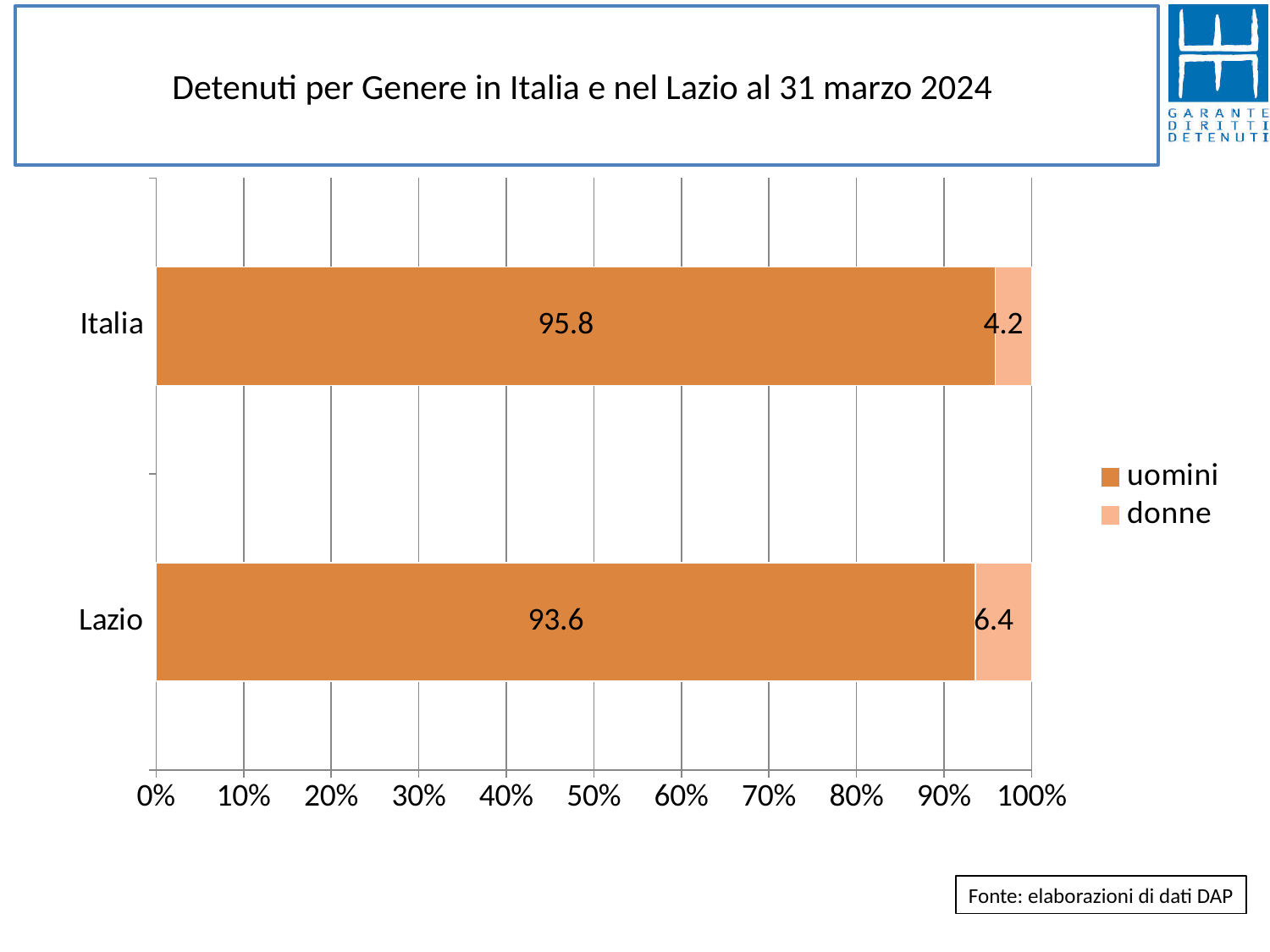
Which category has the higher value for donne, Italia or Lazio? Lazio What is the value for uomini in Italia? 95.8 How many series does the legend list? 2 What kind of chart is shown on the slide? Stacked bar chart Which category has the highest value for uomini? Italia What is the total of the stacked bar for Lazio? 100 What is the value for donne in Italia? 4.2 What is the value for uomini in Lazio? 93.6 How many categories are shown on the chart? 2 What is the difference between the uomini values for Italia and Lazio? 2.2 What is the value for donne in Lazio? 6.4 What is the difference between the donne values for Lazio and Italia? 2.2